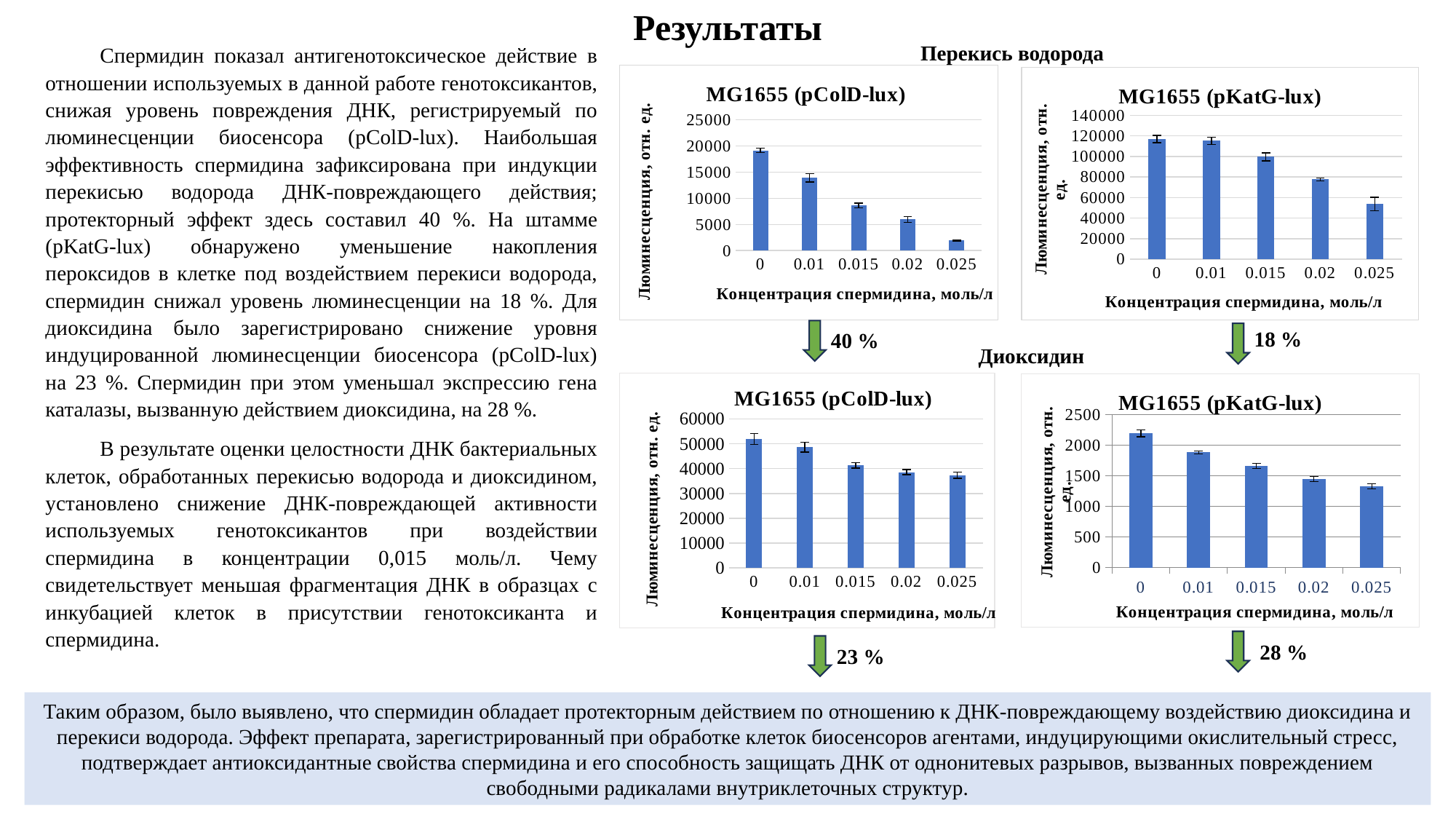
In the bottom-right chart (Диоксидин, MG1655 (pKatG-lux)), is the value for concentration 0 greater or less than 2000? greater In the top-left chart (Перекись водорода, MG1655 (pColD-lux)), is the value for concentration 0.025 greater or less than 5000? less What is the x-axis label of the top-left chart (Перекись водорода, MG1655 (pColD-lux))? Концентрация спермидина, моль/л In the top-left chart (Перекись водорода, MG1655 (pColD-lux)), is the value for concentration 0 greater or less than 15000? greater What kind of chart is the bottom-right chart (Диоксидин, MG1655 (pKatG-lux))? bar chart In the top-right chart (Перекись водорода, MG1655 (pKatG-lux)), which is larger: the value for 0.015 or the value for 0.02? 0.015 In the bottom-left chart (Диоксидин, MG1655 (pColD-lux)), how many spermidine concentrations are plotted? 5 In the top-left chart (Перекись водорода, MG1655 (pColD-lux)), which spermidine concentration has the highest luminescence? 0 In the bottom-right chart (Диоксидин, MG1655 (pKatG-lux)), do the values rise or fall as spermidine concentration increases? fall In the top-left chart (Перекись водорода, MG1655 (pColD-lux)), which spermidine concentration has the lowest luminescence? 0.025